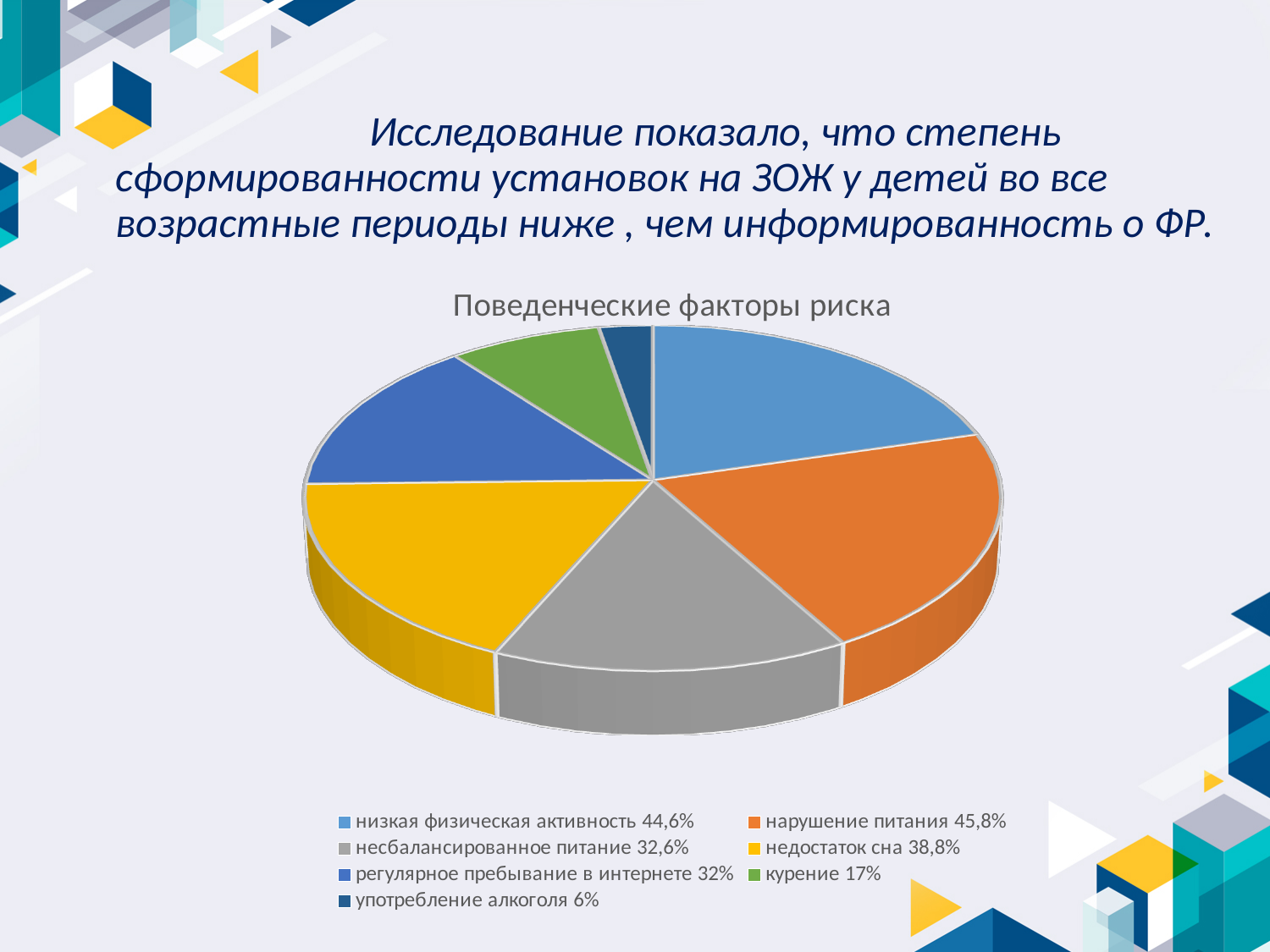
What is the difference between the values for нарушение питания and низкая физическая активность? 1,2% How many categories does the pie chart have? 7 What value is given for курение? 17% What value is given for регулярное пребывание в интернете? 32% What kind of chart is shown on the slide? pie chart What is the difference between the values for курение and употребление алкоголя? 11% Which category has the highest value? нарушение питания What value is given for низкая физическая активность? 44,6% What is the title of the chart? Поведенческие факторы риска Which is larger, the value for недостаток сна or the value for несбалансированное питание? недостаток сна What value is given for недостаток сна? 38,8% Which category has the lowest value? употребление алкоголя